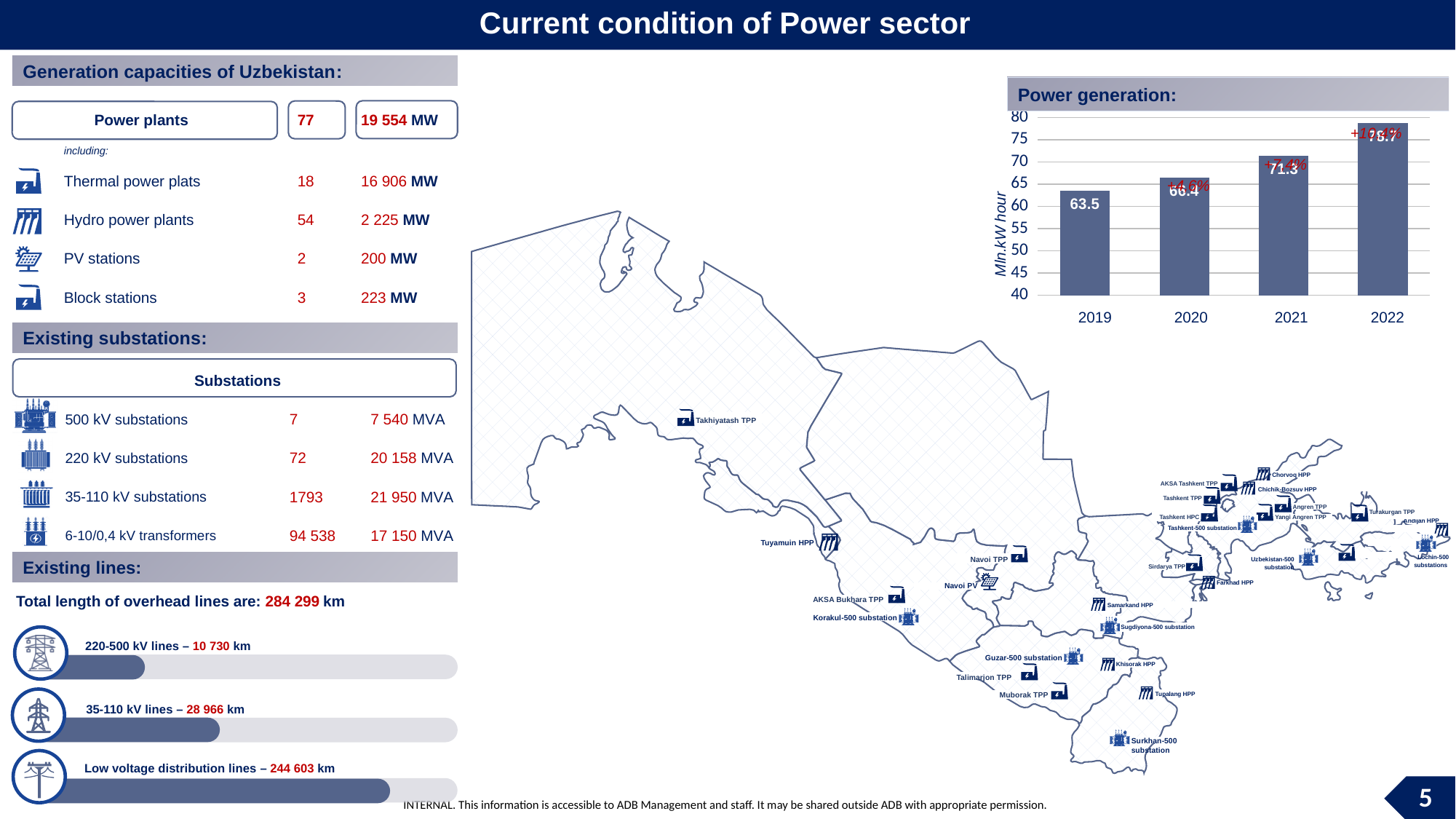
What kind of chart is the Power generation chart? bar chart In the Power generation chart, what is the difference between the 2021 and 2019 values? 7.8 In the Power generation chart, which is larger, the value for 2020 or the value for 2021? 2021 In the Power generation chart, do the values rise or fall from 2019 to 2022? rise In the Power generation chart, what is the value for 2021? 71.3 In the Power generation chart, which year has the highest power generation? 2022 In the Power generation chart, what is the value for 2019? 63.5 In the Power generation chart, which year has the lowest power generation? 2019 In the Power generation chart, what is the value for 2020? 66.4 What is the label on the vertical axis of the Power generation chart? Mln.kW hour In the Power generation chart, is the value for 2022 greater or less than 75? greater How many years are shown in the Power generation chart? 4